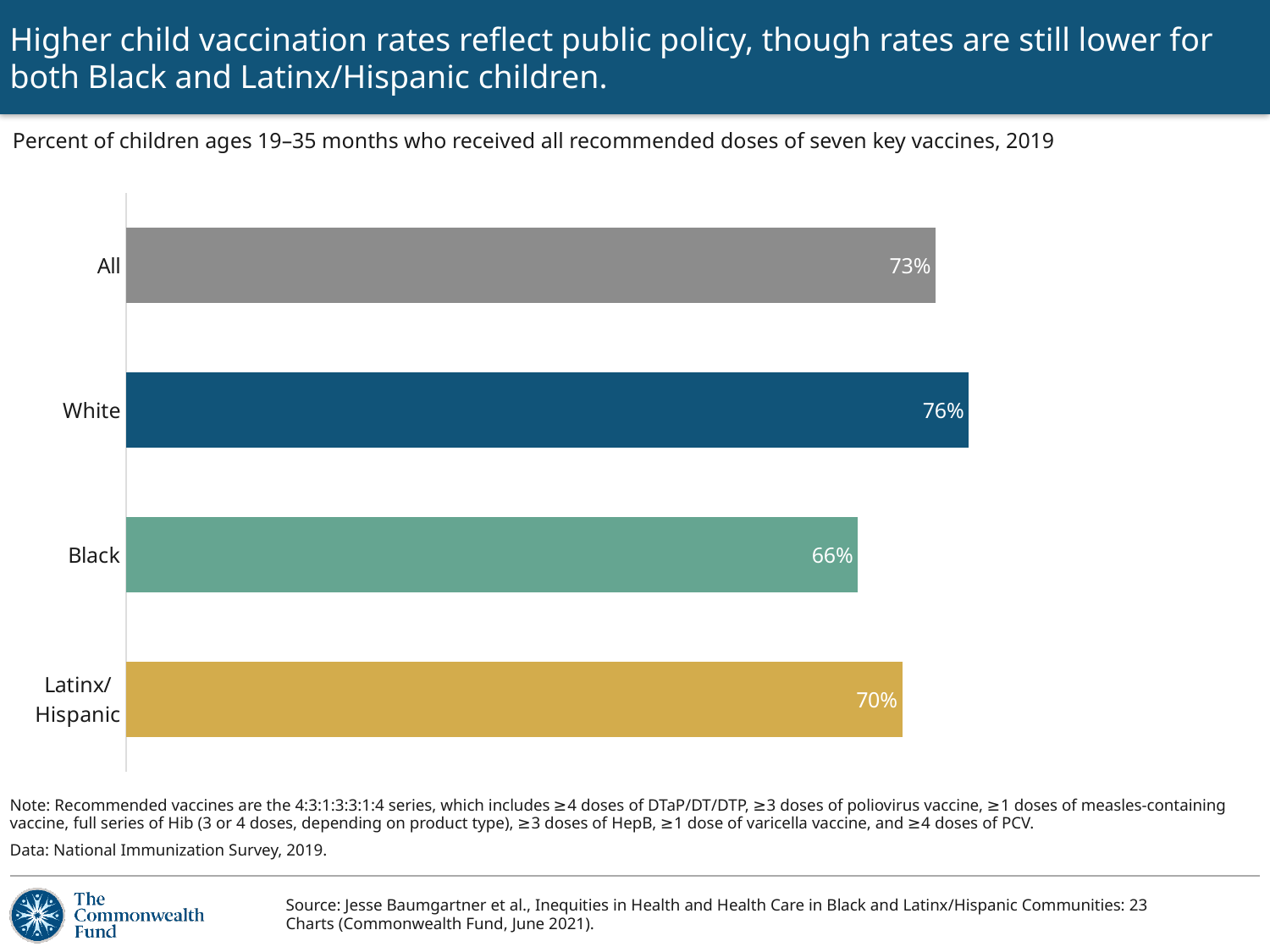
Which is larger, the vaccination rate for Latinx/Hispanic children or for Black children? Latinx/Hispanic What is the vaccination rate shown for Black children? 66% What kind of chart is shown on the slide? Bar chart What year does the chart's data refer to? 2019 What is the difference in percentage points between the vaccination rates for White and Black children? 10 percentage points What is the difference in percentage points between the vaccination rates for Latinx/Hispanic and Black children? 4 percentage points Which group has the lowest vaccination rate on the chart? Black What is the vaccination rate shown for White children? 76% What is the vaccination rate shown for Latinx/Hispanic children? 70% Which group has the highest vaccination rate on the chart? White How many groups are shown on the chart? 4 What percent of all children ages 19–35 months received all recommended doses of seven key vaccines in 2019? 73%